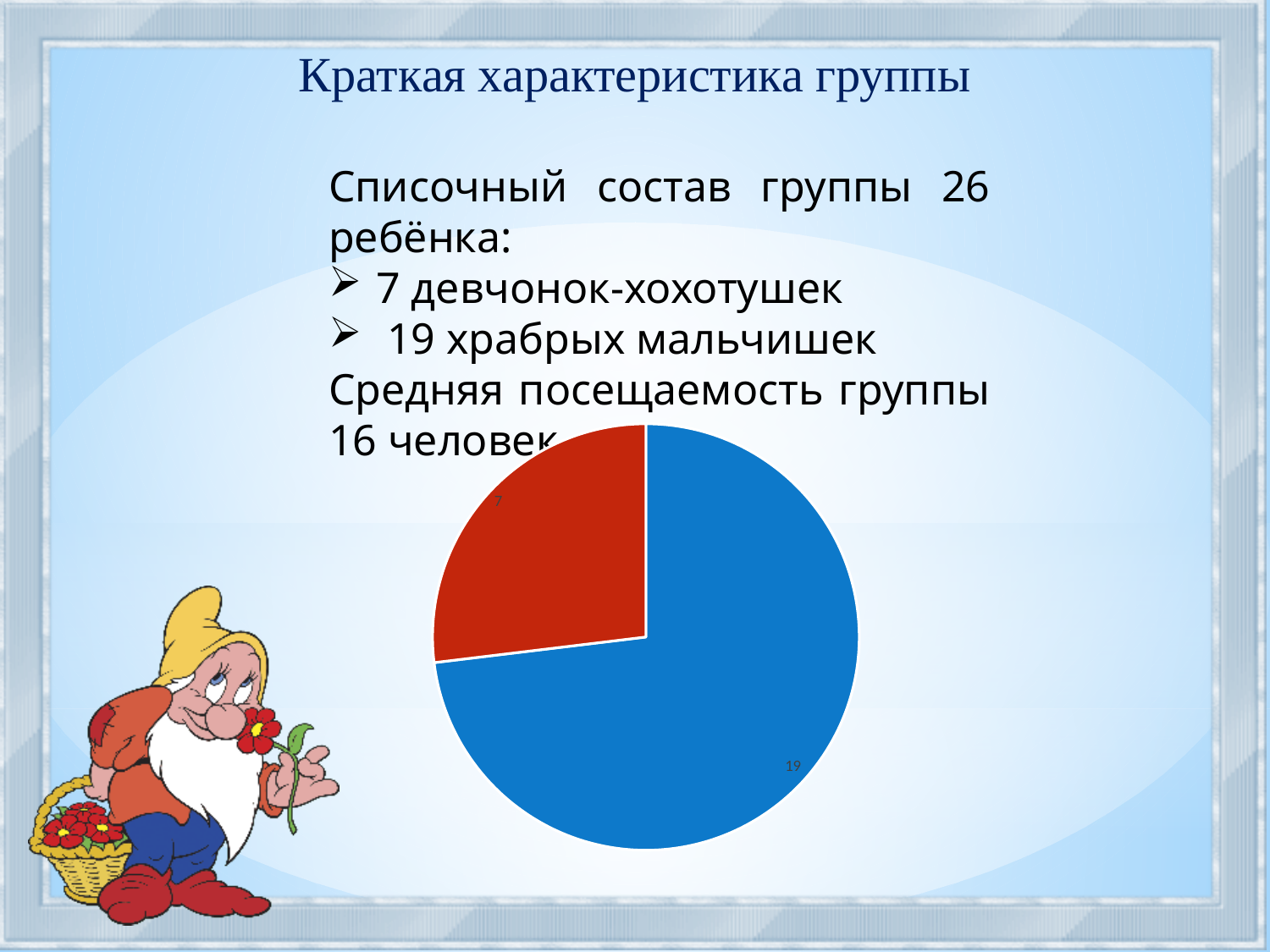
Does the pie chart have a legend? no What kind of chart is shown on the slide? pie chart What value is printed on the red slice of the pie chart? 7 Which slice of the pie chart is the smallest? the red slice (7) How many slices does the pie chart have? 2 What is the difference between the values of the blue slice and the red slice in the pie chart? 12 What colour is the slice labelled 19 in the pie chart? blue Which is larger in the pie chart, the blue slice or the red slice? the blue slice What value is printed on the blue slice of the pie chart? 19 What is the total of the two slice values in the pie chart? 26 Which slice of the pie chart is the largest? the blue slice (19)